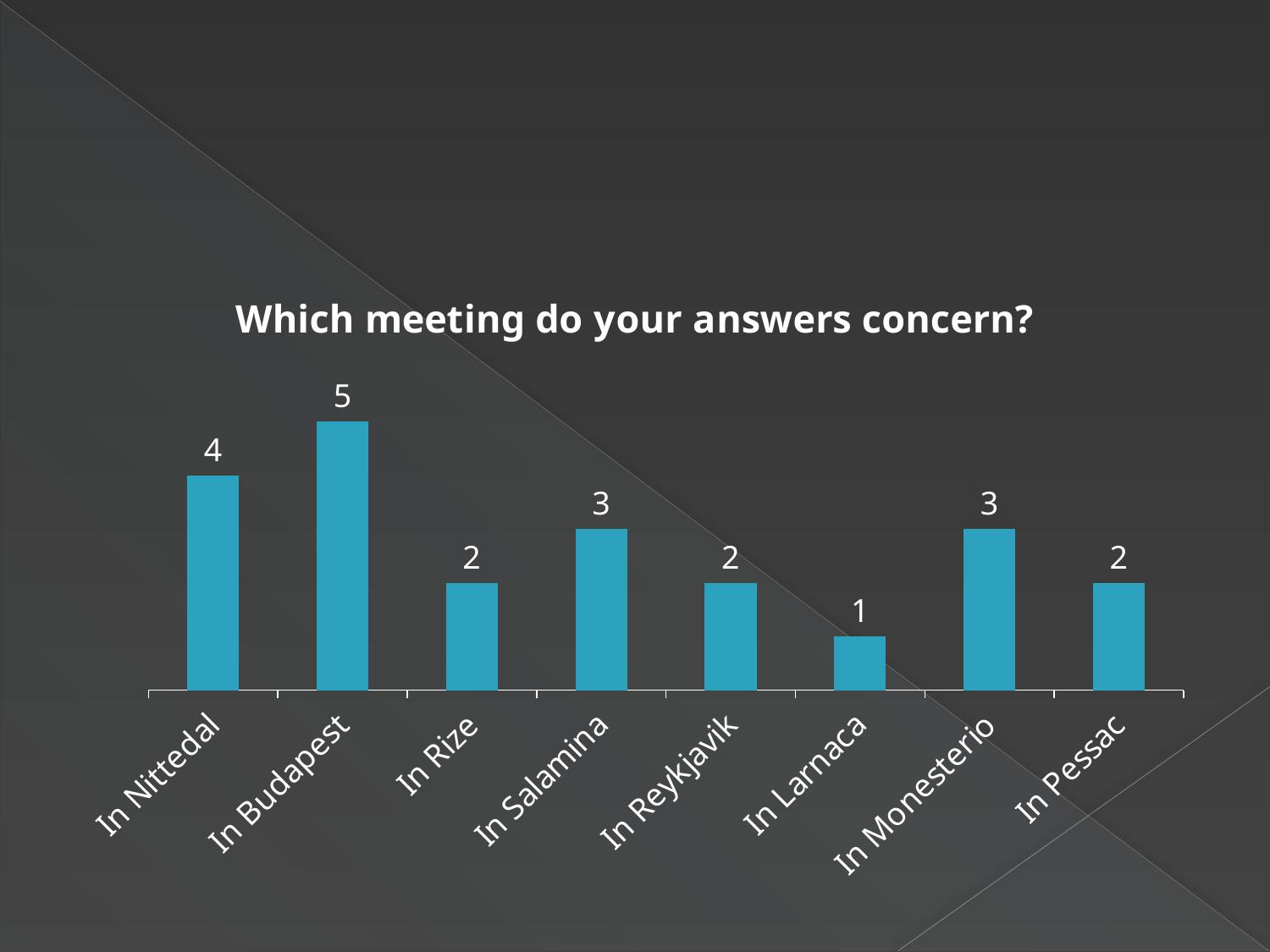
What is the difference between the values for In Nittedal and In Rize? 2 What is the value for In Budapest? 5 What is the title of the chart? Which meeting do your answers concern? Which category has the highest value? In Budapest What is the value for In Monesterio? 3 Which is larger, the value for In Salamina or the value for In Pessac? In Salamina What kind of chart is this? Bar chart What is the difference between the values for In Budapest and In Larnaca? 4 What is the value for In Nittedal? 4 What is the value for In Larnaca? 1 Which category has the lowest value? In Larnaca How many categories are shown on the x axis? 8